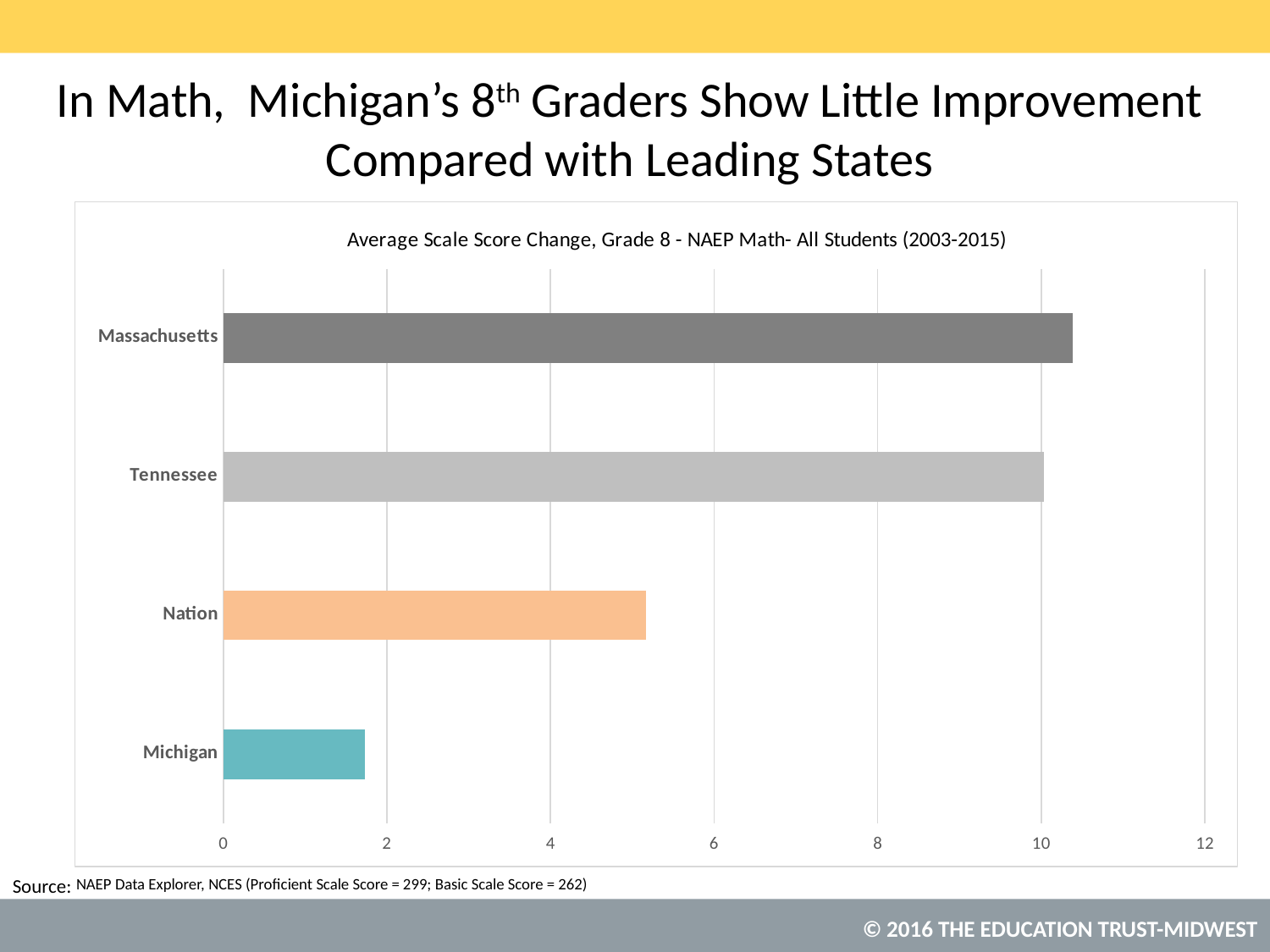
Is the value for Nation greater or less than 4? greater How many categories are plotted in the chart? 4 Is the value for Nation greater or less than 6? less Which has a larger average scale score change, Tennessee or Nation? Tennessee Is the value for Massachusetts greater or less than 10? greater What is the title of the chart? Average Scale Score Change, Grade 8 - NAEP Math- All Students (2003-2015) What kind of chart is shown on the slide? bar chart What colour is the bar for Michigan? teal Which has a larger average scale score change, Nation or Michigan? Nation Which category has the lowest average scale score change? Michigan